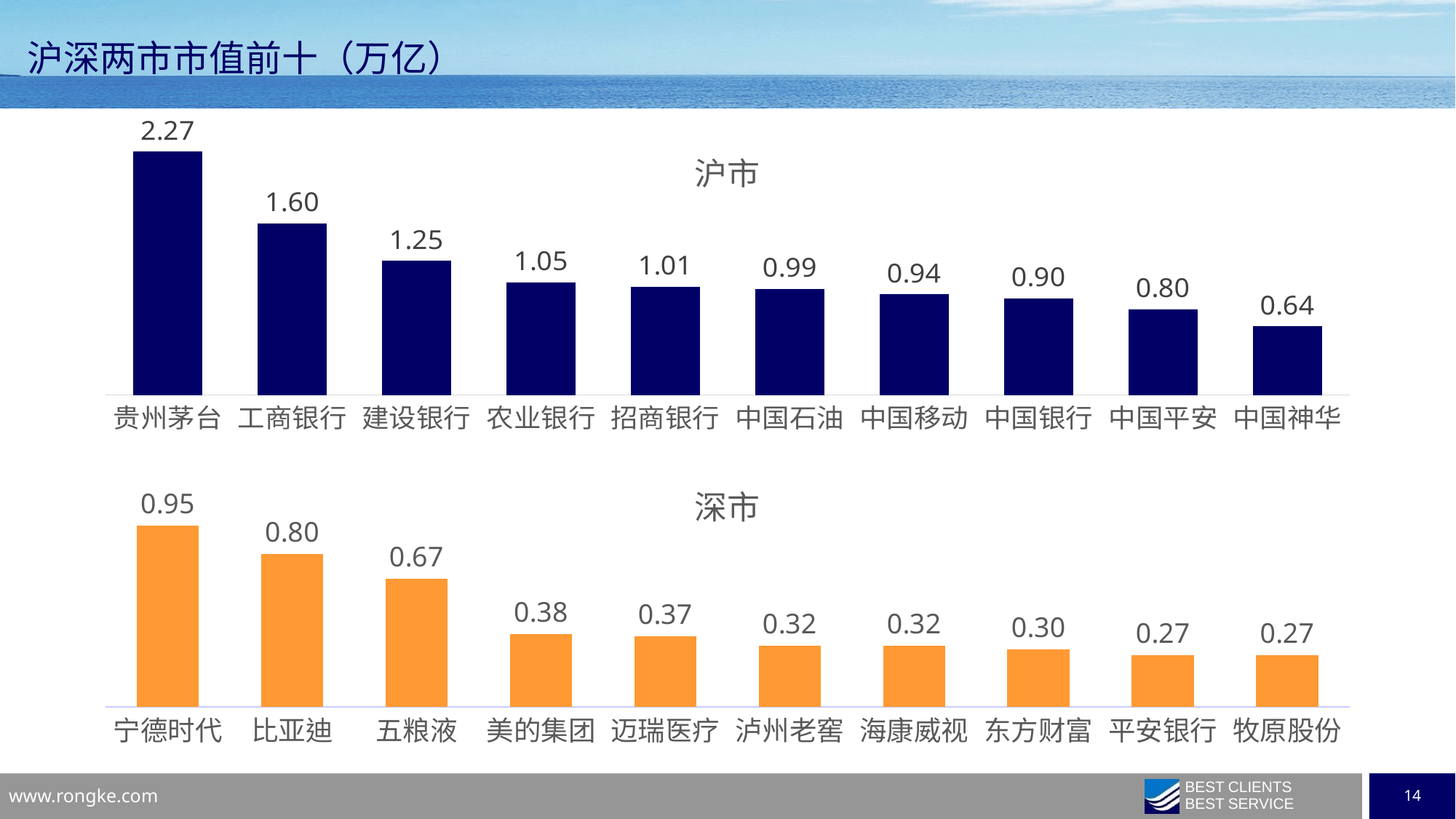
In the 沪市 chart, what is the value for 中国石油? 0.99 In the 沪市 chart, what is the difference between 贵州茅台 and 工商银行? 0.67 In the 沪市 chart, which is larger, 建设银行 or 农业银行? 建设银行 In the 深市 chart, what is the value for 迈瑞医疗? 0.37 In the 深市 chart, which company has the highest value? 宁德时代 In the 深市 chart, what is the difference between 宁德时代 and 五粮液? 0.28 In the 沪市 chart, what is the value for 贵州茅台? 2.27 In the 深市 chart, what is the value for 比亚迪? 0.80 How many companies are shown in the 深市 chart? 10 What type of chart is the 沪市 chart? Bar chart In the 沪市 chart, which company has the lowest value? 中国神华 In the 深市 chart, do the values rise or fall from left to right? Fall